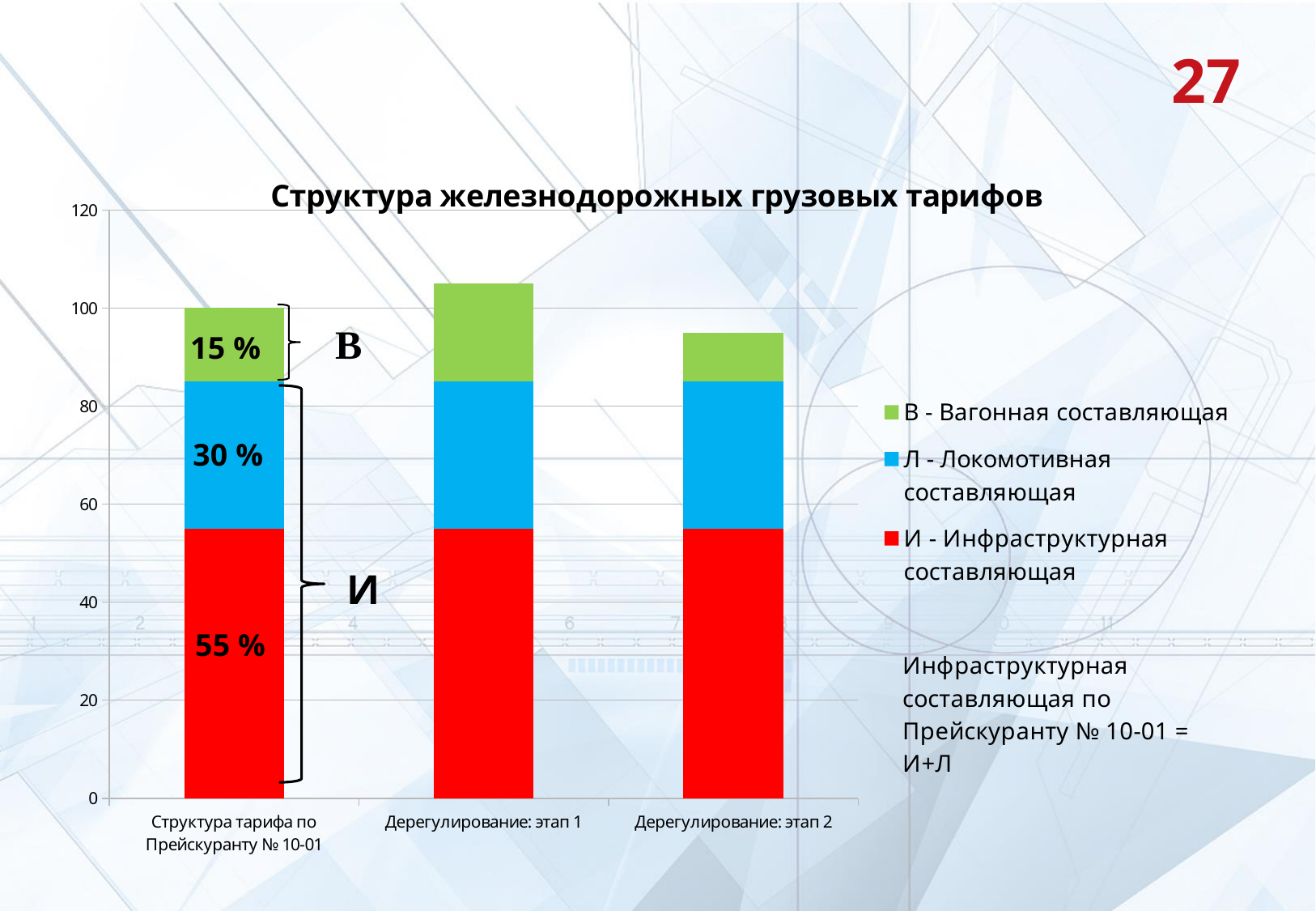
What is the title of the chart? Структура железнодорожных грузовых тарифов What is the difference between the И and В segments for Структура тарифа по Прейскуранту № 10-01? 40 % What is the value of the В - Вагонная составляющая segment for Структура тарифа по Прейскуранту № 10-01? 15 % How many categories are shown on the x axis? 3 What is the value of the Л - Локомотивная составляющая segment for Структура тарифа по Прейскуранту № 10-01? 30 % What is the total of the stacked bar for Структура тарифа по Прейскуранту № 10-01? 100 % How many series does the legend list? 3 Is the total of the bar for Дерегулирование: этап 2 greater or less than 100? less Which category has the tallest stacked bar? Дерегулирование: этап 1 What is the value of the И - Инфраструктурная составляющая segment for Структура тарифа по Прейскуранту № 10-01? 55 % Which category has the shortest stacked bar? Дерегулирование: этап 2 What kind of chart is shown on the slide? Stacked bar chart